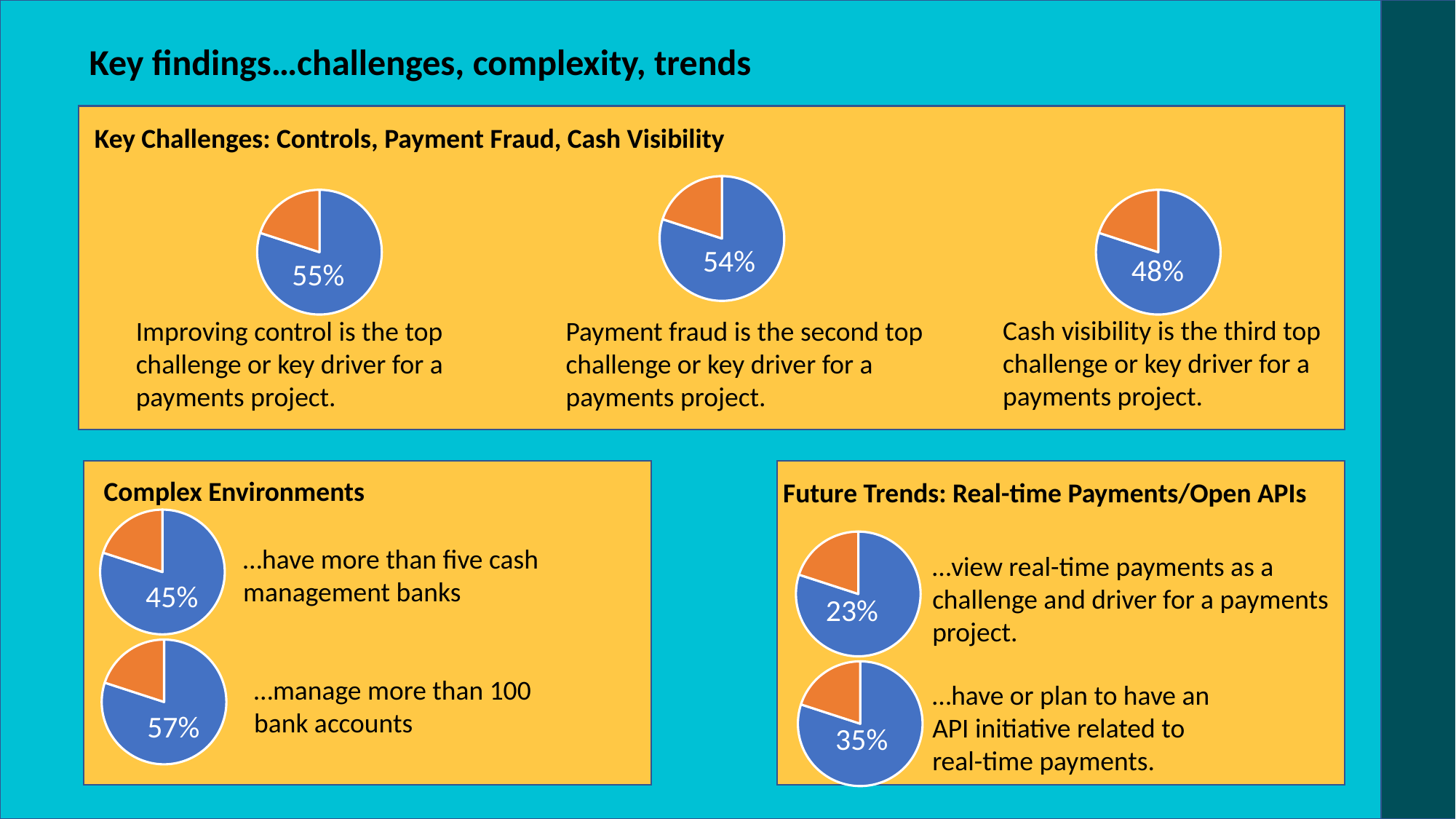
In the Key Challenges section, which of the three challenges has the lowest labelled percentage? Cash visibility How many pie charts are shown on the slide in total? 7 In the Key Challenges section, what percentage is shown on the pie chart for improving control as the top challenge? 55% In the Complex Environments section, what percentage have more than five cash management banks? 45% In the Key Challenges section, what percentage is shown on the pie chart for cash visibility? 48% What is the difference between the percentage that manage more than 100 bank accounts and the percentage that have more than five cash management banks? 12% In the Complex Environments section, what percentage manage more than 100 bank accounts? 57% In the Key Challenges section, what percentage is shown on the pie chart for payment fraud? 54% In the Future Trends section, which is larger: the percentage viewing real-time payments as a challenge and driver, or the percentage with an API initiative? API initiative (35%) In the Future Trends section, what percentage have or plan to have an API initiative related to real-time payments? 35% What type of chart is used throughout the slide to display the percentages? Pie chart In the Future Trends section, what percentage view real-time payments as a challenge and driver for a payments project? 23%